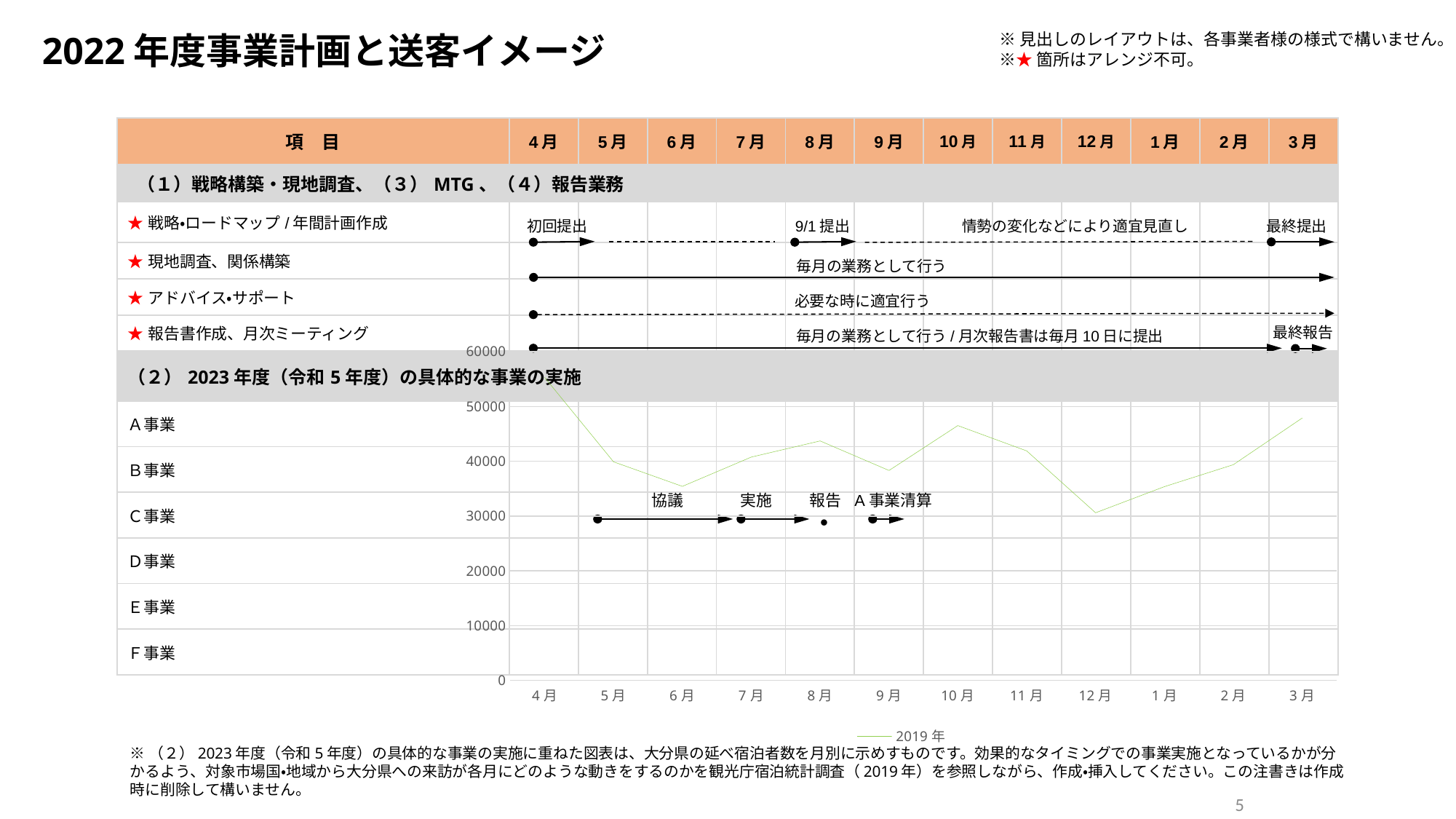
Is the value for 3月 greater or less than 40000? greater Is the value for 12月 greater or less than 40000? less Is the value for 10月 greater or less than 40000? greater What kind of chart is overlaid on the table in the lower part of the slide? line chart What is the name of the series shown in the chart's legend? 2019年 How many series does the chart's legend list? 1 Which month has the lowest value on the 2019年 line? 12月 Which is larger, the value for 10月 or the value for 12月? 10月 Which month has the highest value on the 2019年 line? 4月 Do the values rise or fall from 12月 to 3月? rise How many months are shown on the chart's x axis? 12